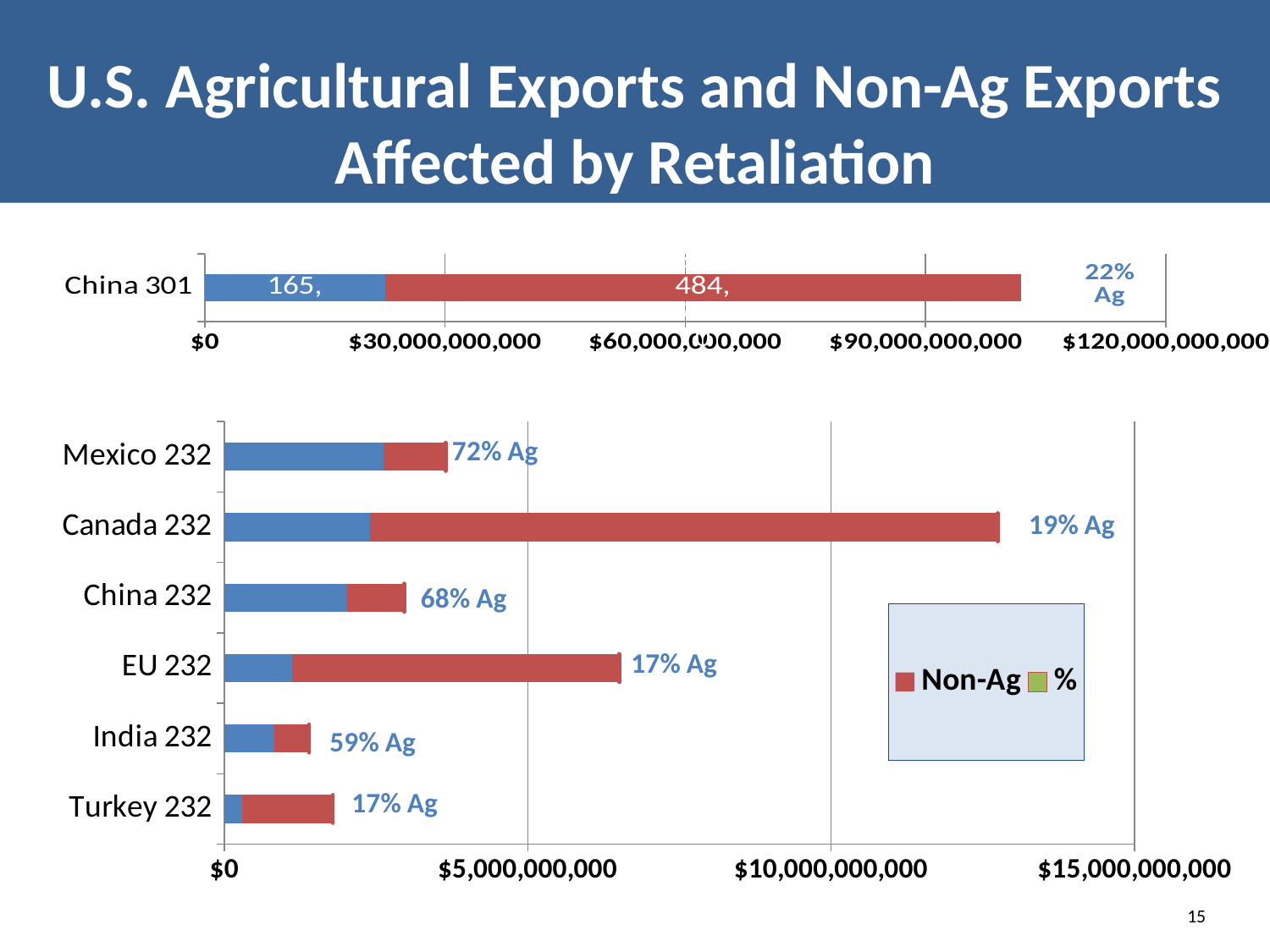
In the bottom chart, is the total bar for Mexico 232 greater or less than $5,000,000,000? less How many categories are shown in the bottom chart? 6 In the bottom chart, what is the Ag share shown for Mexico 232? 72% Ag In the bottom chart, which category has the highest Ag share? Mexico 232 What kind of chart is the bottom chart? Bar chart In the bottom chart, what is the Ag share shown for India 232? 59% Ag In the bottom chart, which category has the longest total bar? Canada 232 In the top chart, what Ag share is shown for China 301? 22% Ag In the bottom chart, what is the Ag share shown for Canada 232? 19% Ag In the bottom chart, is the total bar for Canada 232 greater or less than $10,000,000,000? greater In the top chart, is the total bar for China 301 greater or less than $90,000,000,000? greater In the bottom chart, which has the longer total bar, Canada 232 or EU 232? Canada 232